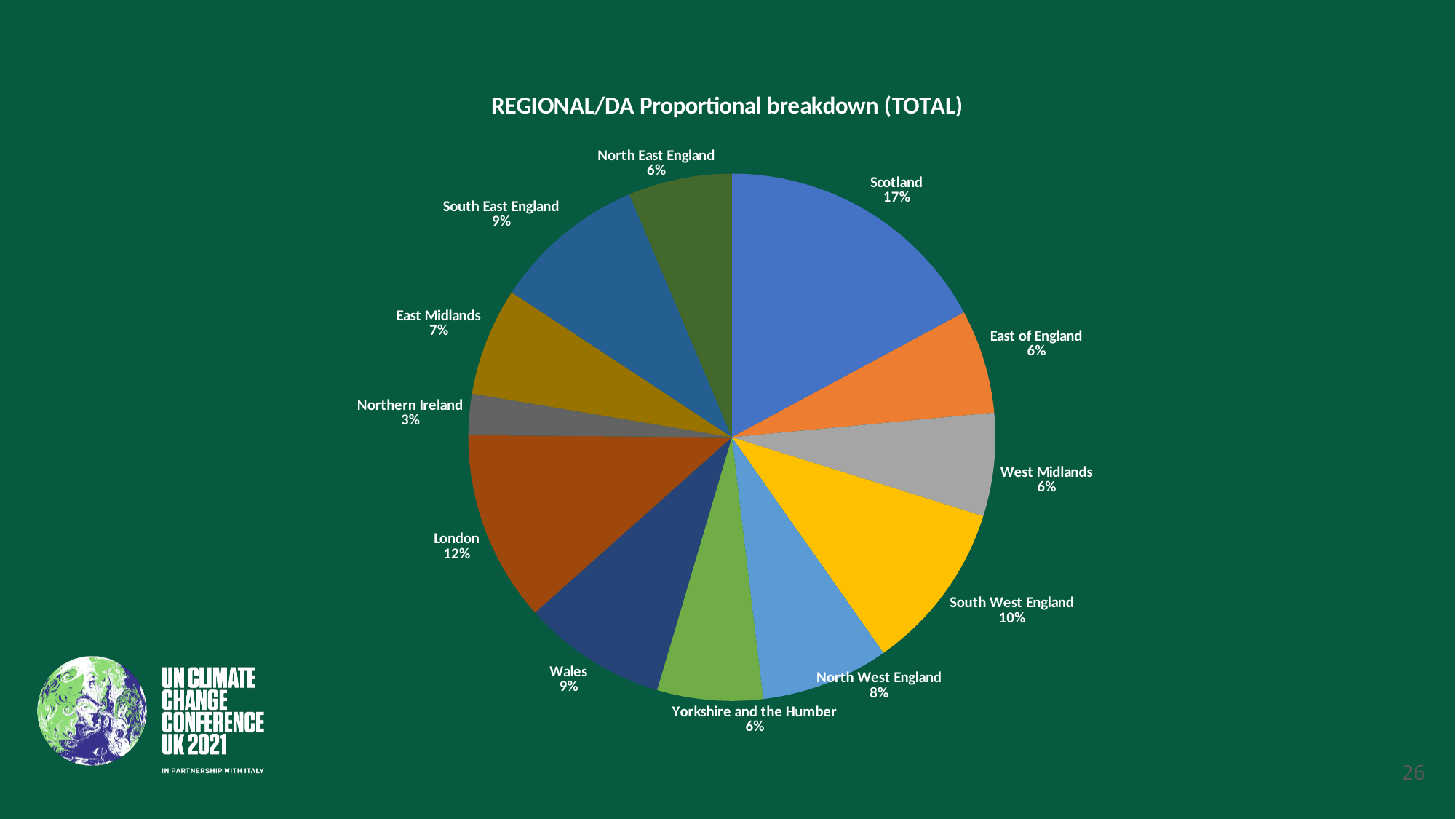
Which region has the smallest slice of the pie? Northern Ireland What is the difference in percentage points between South West England and Northern Ireland? 7 How many slices does the pie chart have? 12 Which is larger, the share for Wales or the share for East Midlands? Wales What is the title of the chart? REGIONAL/DA Proportional breakdown (TOTAL) Which region has the largest slice of the pie? Scotland What percentage is shown for North West England? 8% What type of chart is shown on the slide? Pie chart What percentage is shown for South West England? 10% What share of the pie does Scotland represent? 17% What is the difference in percentage points between Scotland and London? 5 What percentage is shown for London? 12%